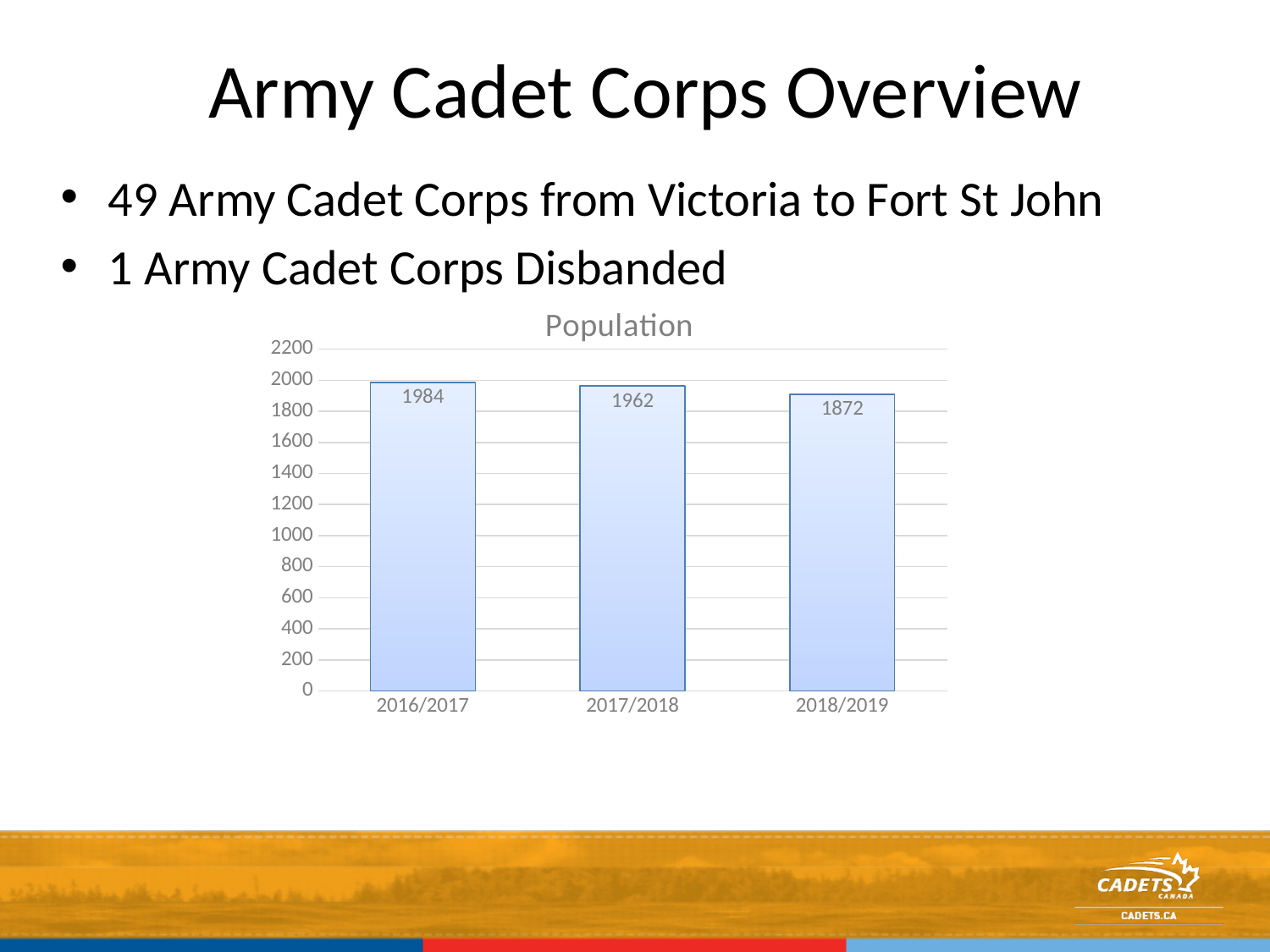
Which year has the lowest population? 2018/2019 Is the population for 2018/2019 greater or less than 2000? less What kind of chart is shown on the slide? bar chart What is the difference in population between 2016/2017 and 2018/2019? 112 What is the population value for 2017/2018? 1962 Does the population rise or fall from 2016/2017 to 2018/2019? fall How many years are shown on the chart? 3 What is the population value for 2018/2019? 1872 Which is larger, the population for 2016/2017 or for 2018/2019? 2016/2017 Which year has the highest population? 2016/2017 What is the difference in population between 2017/2018 and 2018/2019? 90 What is the population value for 2016/2017? 1984